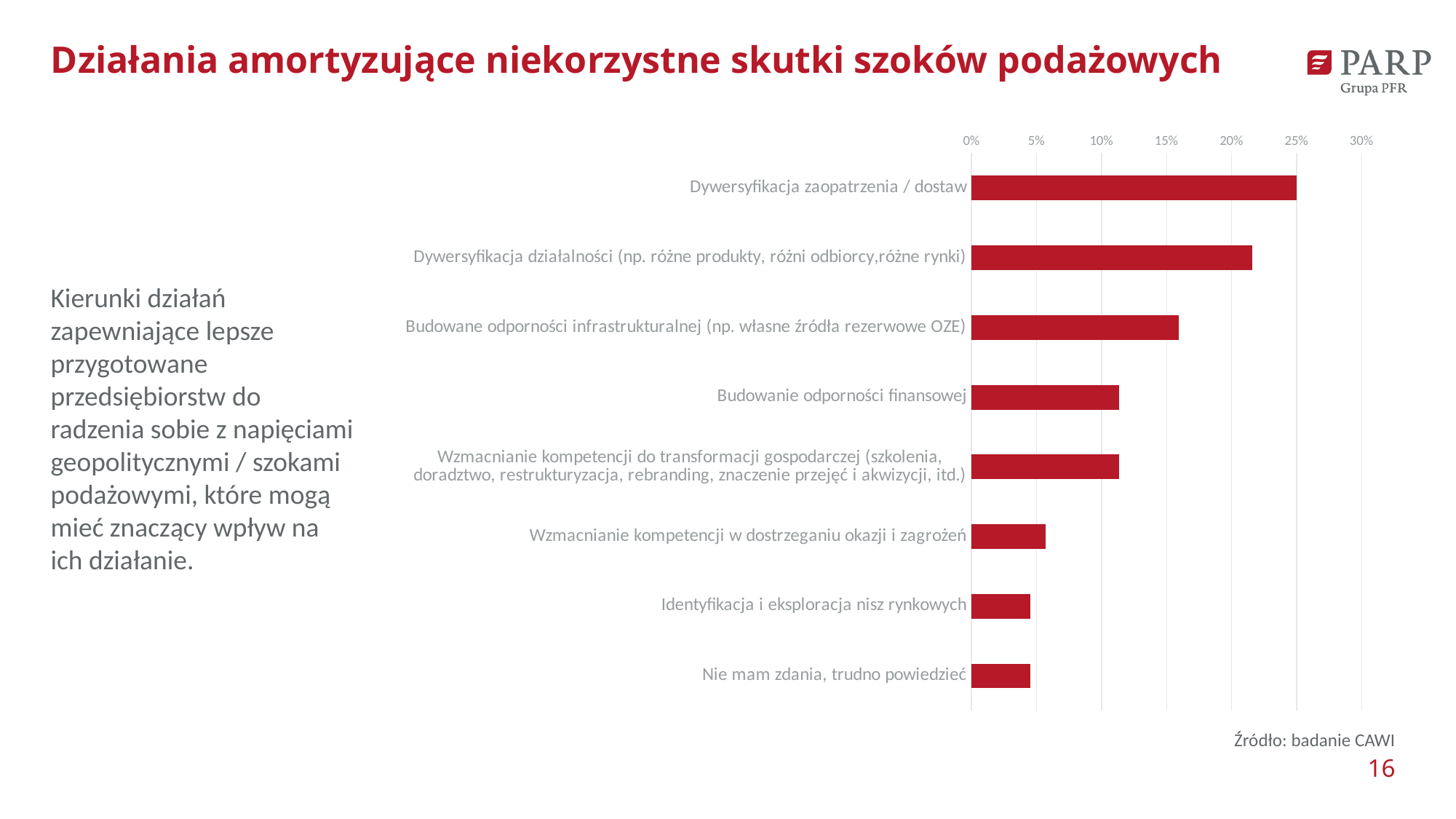
Which is larger: the value for "Dywersyfikacja działalności" or the value for "Budowane odporności infrastrukturalnej"? Dywersyfikacja działalności Is the value for "Budowanie odporności finansowej" greater or less than 10%? greater What is the value for "Dywersyfikacja zaopatrzenia / dostaw"? 25% Is the value for "Dywersyfikacja działalności (np. różne produkty, różni odbiorcy, różne rynki)" greater or less than 20%? greater How many categories (bars) does the chart show? 8 What source is cited for the chart data? badanie CAWI Is the value for "Wzmacnianie kompetencji w dostrzeganiu okazji i zagrożeń" greater or less than 5%? greater Which category has the highest value in the chart? Dywersyfikacja zaopatrzenia / dostaw What kind of chart is shown on the slide? bar chart What colour are the bars in the chart? red